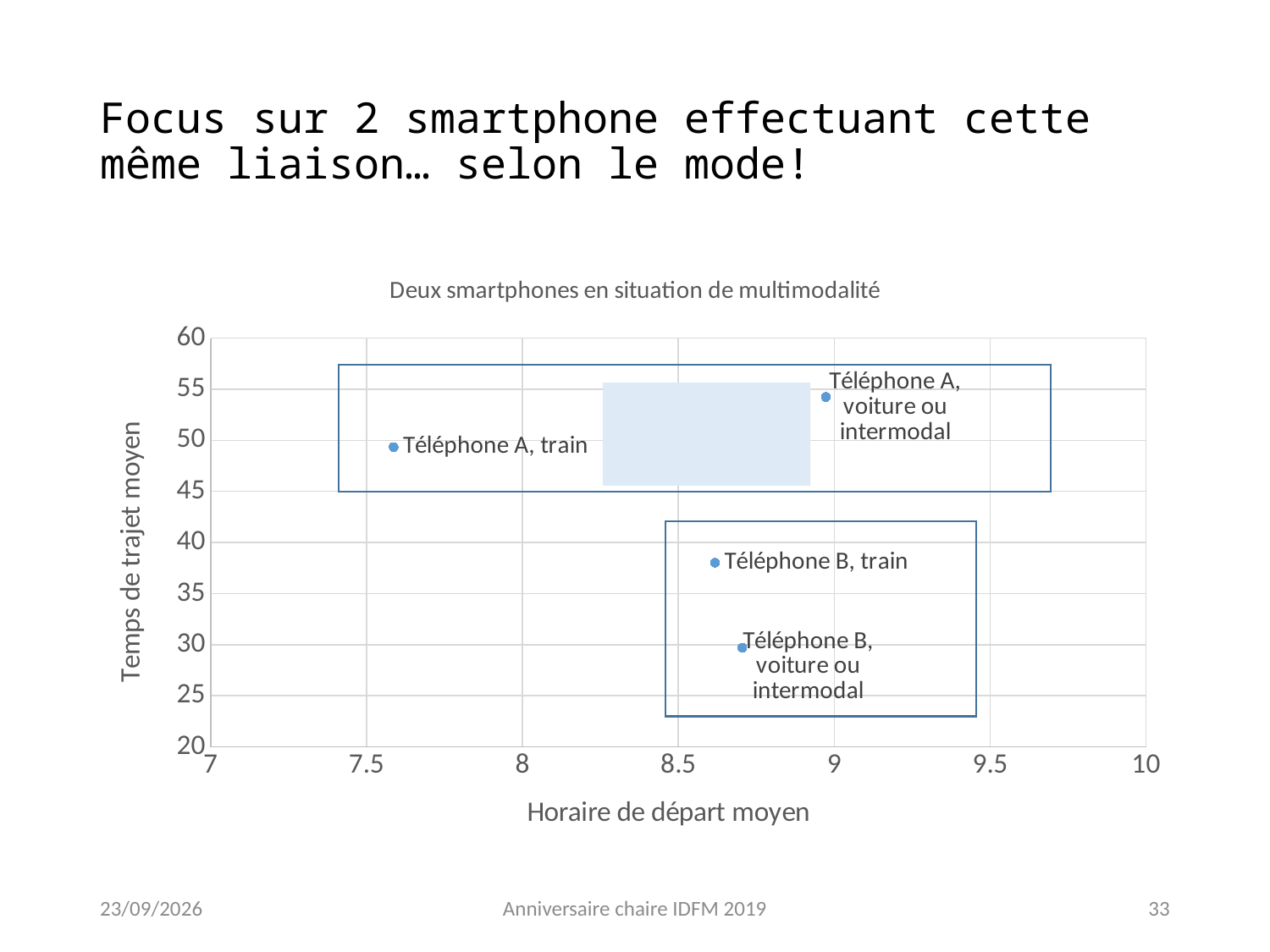
Is the average travel time for Téléphone B, train greater or less than 40? less Which point has the earliest average departure time (Horaire de départ moyen)? Téléphone A, train Is the average travel time for Téléphone A, train greater or less than 45? greater Is the average departure time for Téléphone A, train greater or less than 8? less Which has the higher average travel time: Téléphone A, train or Téléphone B, train? Téléphone A, train What is the title of the chart? Deux smartphones en situation de multimodalité How many data points are plotted on the chart? 4 Which point has the lowest average travel time (Temps de trajet moyen)? Téléphone B, voiture ou intermodal What is the label of the vertical axis? Temps de trajet moyen What kind of chart is shown on the slide? scatter chart Which point has the highest average travel time (Temps de trajet moyen)? Téléphone A, voiture ou intermodal